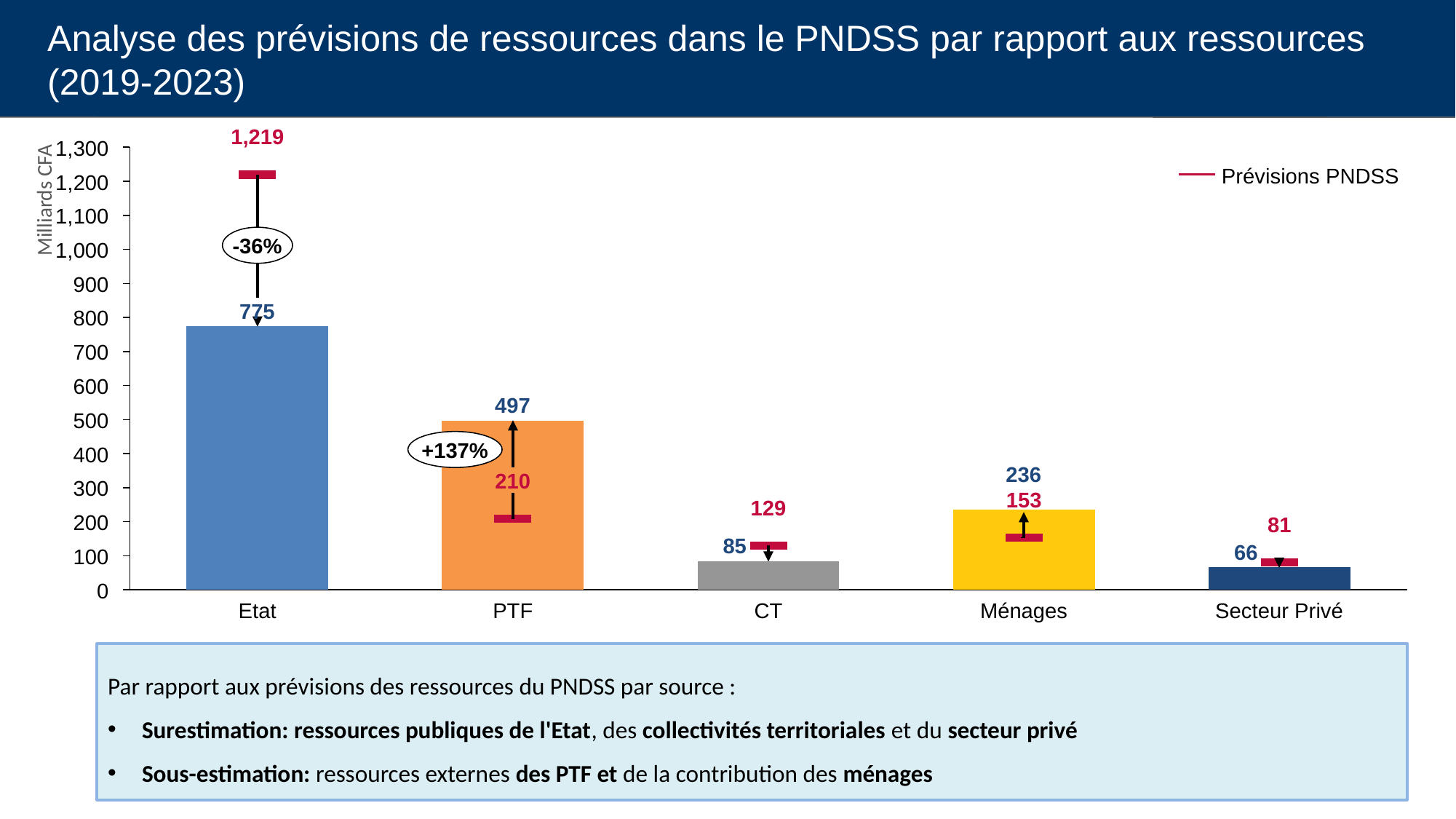
What is the Prévisions PNDSS value for Etat? 1,219 What is the bar value for Ménages? 236 Which category has the highest bar value? Etat What is the Prévisions PNDSS value for PTF? 210 How many series does the legend list? 1 Which is larger for PTF: the bar value or the Prévisions PNDSS value? the bar value (497) What percentage change is shown in the oval label above the PTF bar? +137% What is the actual resource value (bar) for Etat? 775 What is the difference between the bar value and the Prévisions PNDSS value for CT? 44 What kind of chart is shown on the slide? bar chart How many categories are shown on the x axis? 5 Which category has the lowest bar value? Secteur Privé